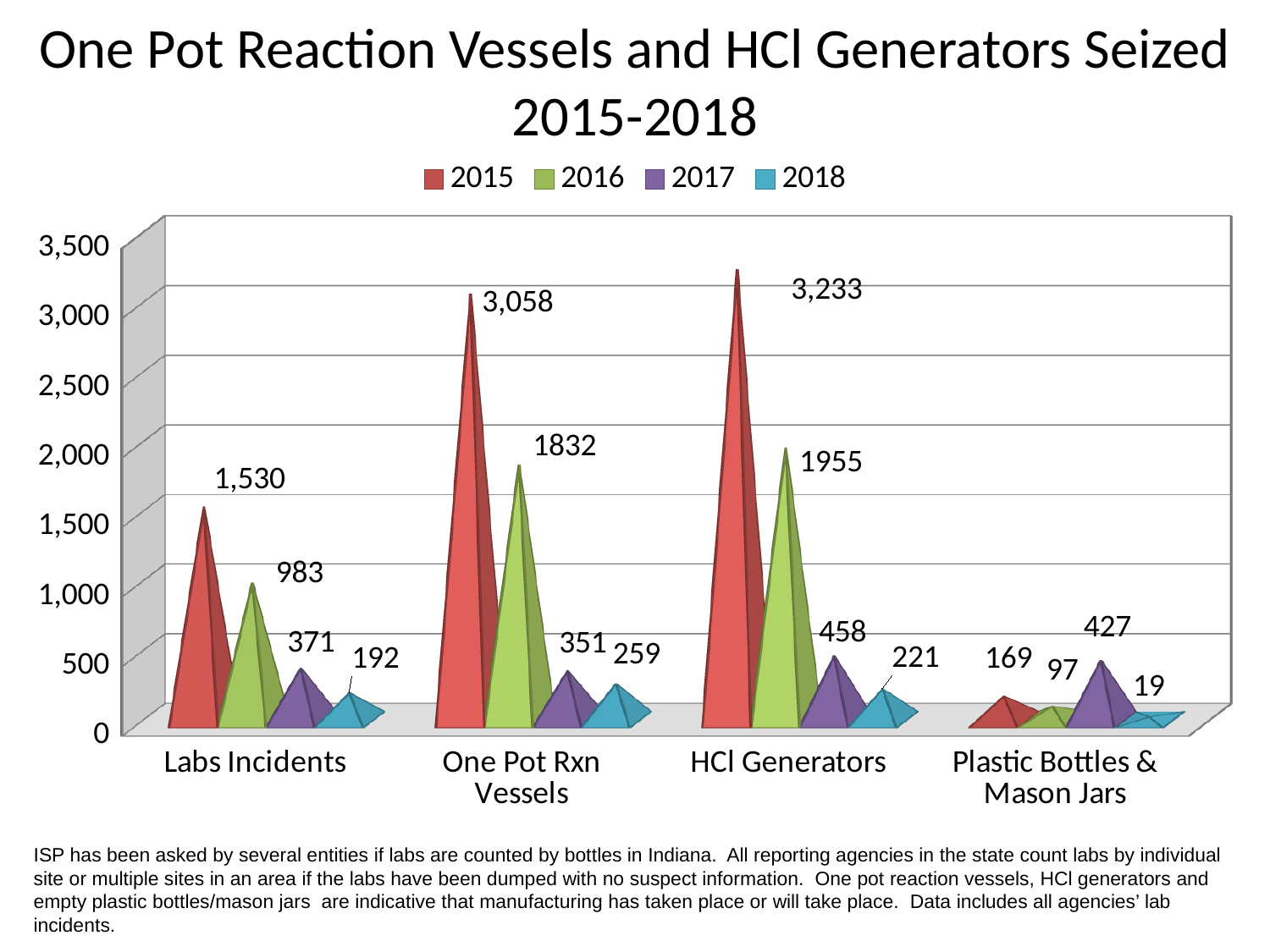
How many series does the legend list? 4 What is the title of the chart? One Pot Reaction Vessels and HCl Generators Seized 2015-2018 What is the 2017 value for Labs Incidents? 371 Which category has the lowest 2018 value? Plastic Bottles & Mason Jars How many categories are shown on the x axis? 4 What is the 2015 value for HCl Generators? 3,233 What kind of chart is shown? bar chart Which is larger for Plastic Bottles & Mason Jars, the 2017 value or the 2015 value? 2017 What is the 2018 value for Plastic Bottles & Mason Jars? 19 Which category has the highest 2015 value? HCl Generators What is the difference between the 2015 and 2016 values for Labs Incidents? 547 What is the 2016 value for One Pot Rxn Vessels? 1832